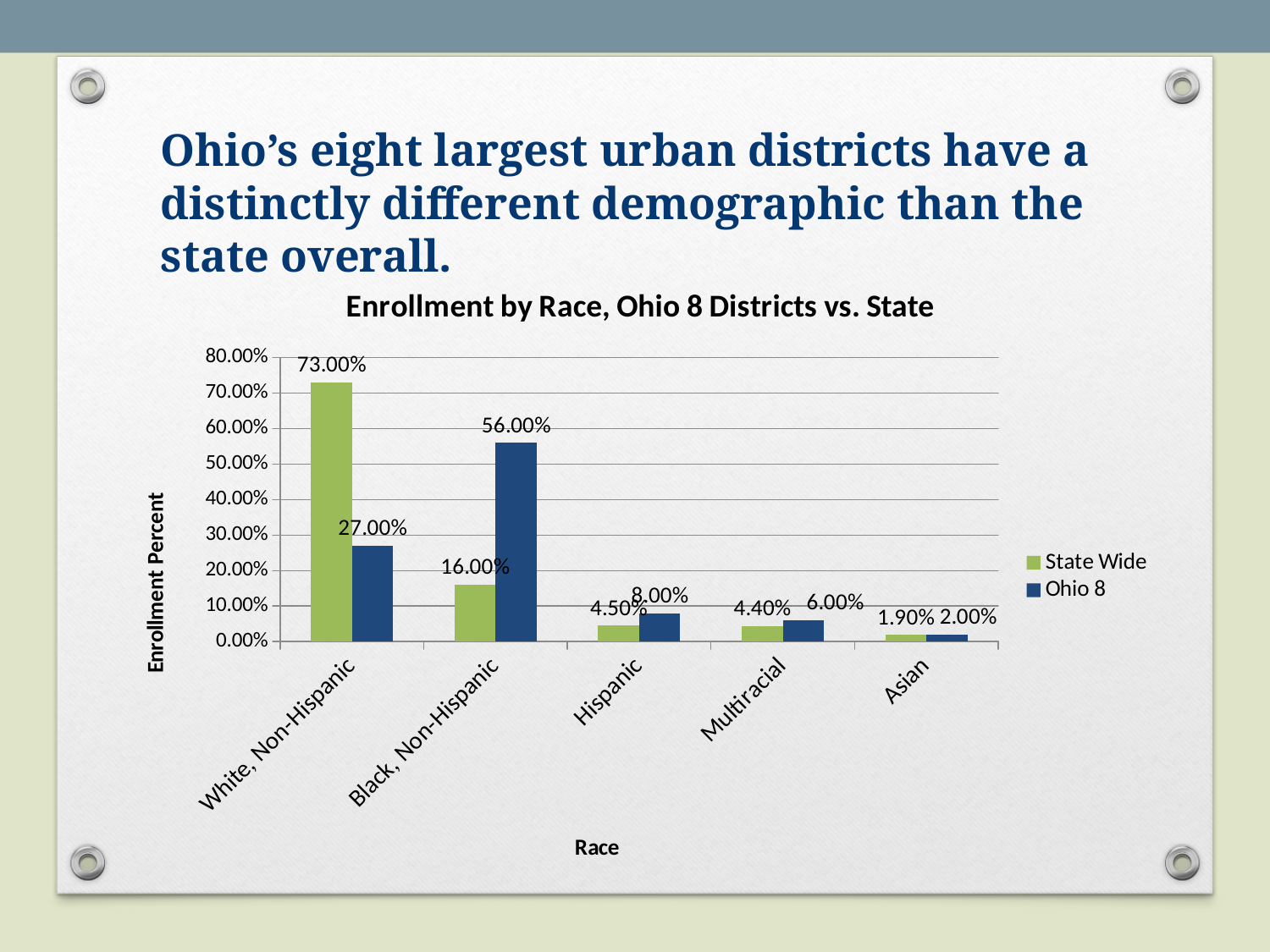
How many series does the legend list? 2 Which race category has the highest State Wide enrollment percent? White, Non-Hispanic What is the difference between the Ohio 8 and State Wide enrollment percents for Black, Non-Hispanic? 40.00% What type of chart is shown on the slide? Bar chart For Multiracial, which is larger: the State Wide or the Ohio 8 enrollment percent? Ohio 8 What is the State Wide enrollment percent for White, Non-Hispanic? 73.00% How many race categories are shown on the x axis? 5 What is the State Wide enrollment percent for Asian? 1.90% What is the Ohio 8 enrollment percent for Hispanic? 8.00% What is the difference between the State Wide and Ohio 8 enrollment percents for White, Non-Hispanic? 46.00% Which race category has the lowest Ohio 8 enrollment percent? Asian What is the Ohio 8 enrollment percent for Black, Non-Hispanic? 56.00%